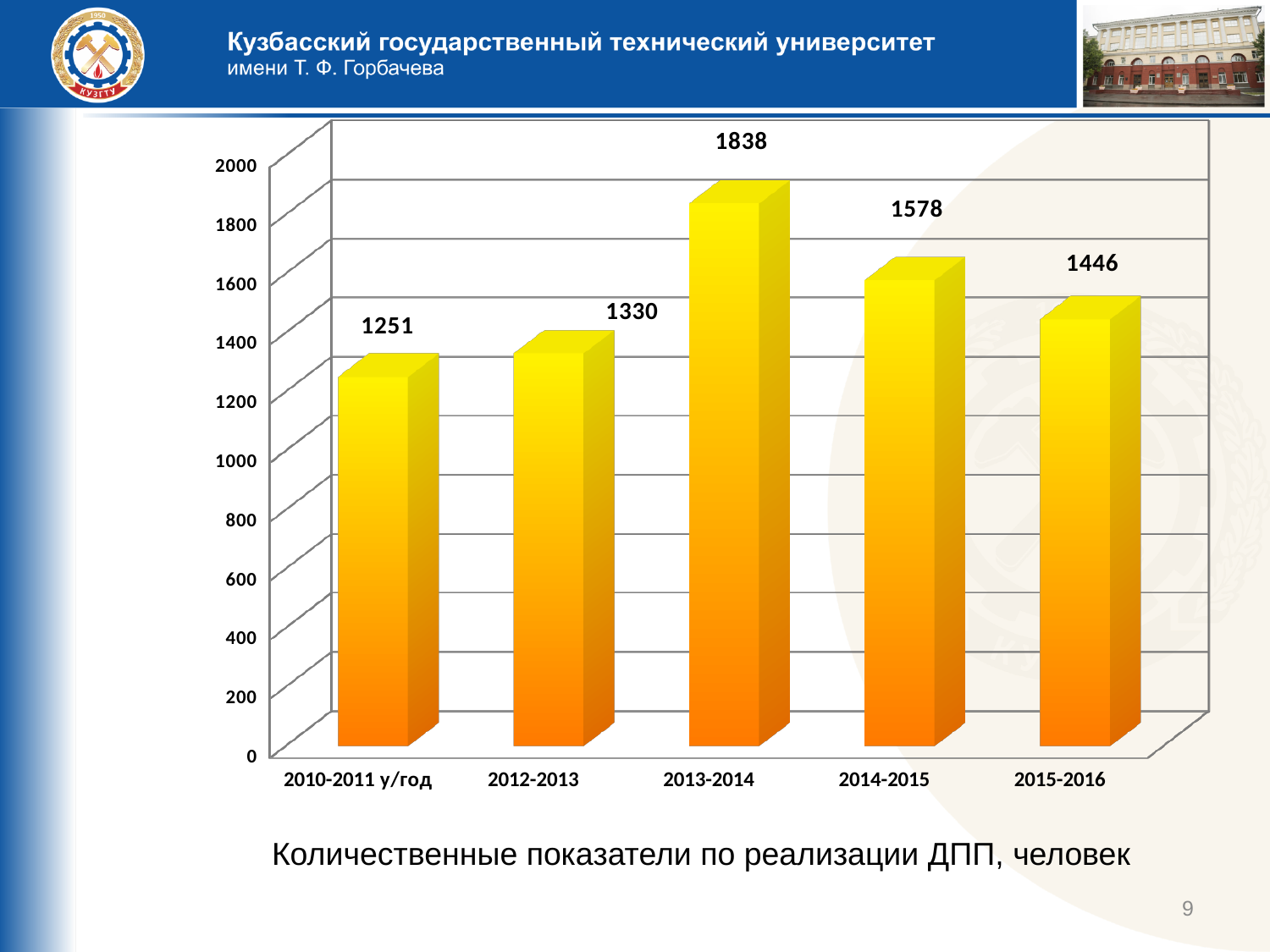
What is the caption below the chart? Количественные показатели по реализации ДПП, человек What is the difference between the values for 2012-2013 and 2010-2011 у/год? 79 What is the difference between the values for 2013-2014 and 2014-2015? 260 Which category has the highest value? 2013-2014 What is the value for 2015-2016? 1446 What is the value for 2010-2011 у/год? 1251 What kind of chart is shown on the slide? bar chart Is the value for 2013-2014 greater or less than 1600? greater How many categories are shown on the x axis? 5 Which category has the lowest value? 2010-2011 у/год Which is larger, the value for 2014-2015 or the value for 2015-2016? 2014-2015 What is the value for 2013-2014? 1838